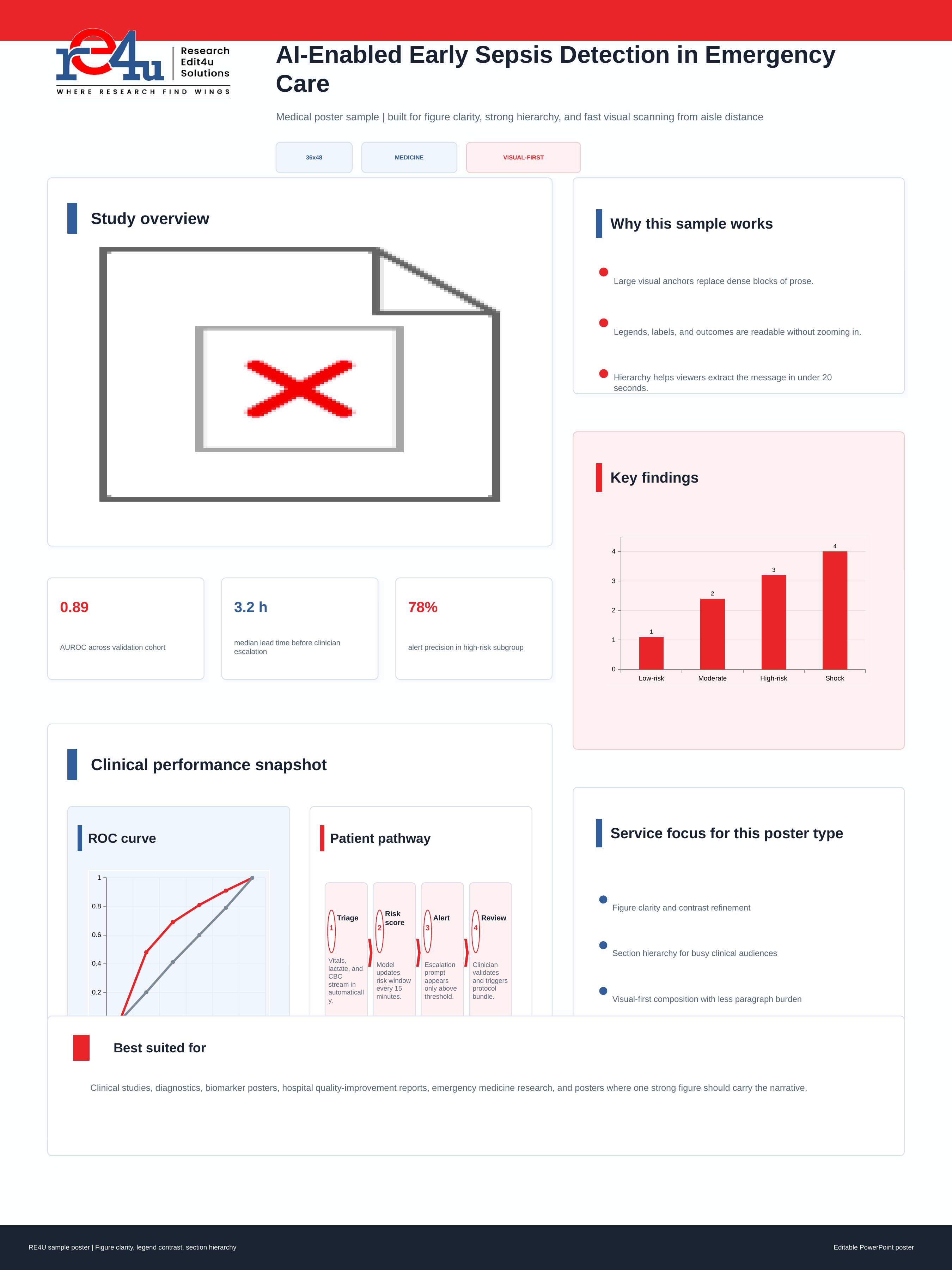
In the Key findings chart, which is larger, the value for Moderate or the value for High-risk? High-risk In the Key findings chart, which category has the lowest value? Low-risk In the Key findings chart, what is the value for High-risk? 3 What kind of chart is shown in the Key findings section? Bar chart In the Key findings chart, what is the value for Moderate? 2 In the Key findings chart, do the values rise or fall from Low-risk to Shock? Rise In the Key findings chart, what is the value for Low-risk? 1 In the Key findings chart, what is the value for Shock? 4 In the Key findings chart, which category has the highest value? Shock What kind of chart is shown in the ROC curve panel? Line chart How many categories are shown in the Key findings chart? 4